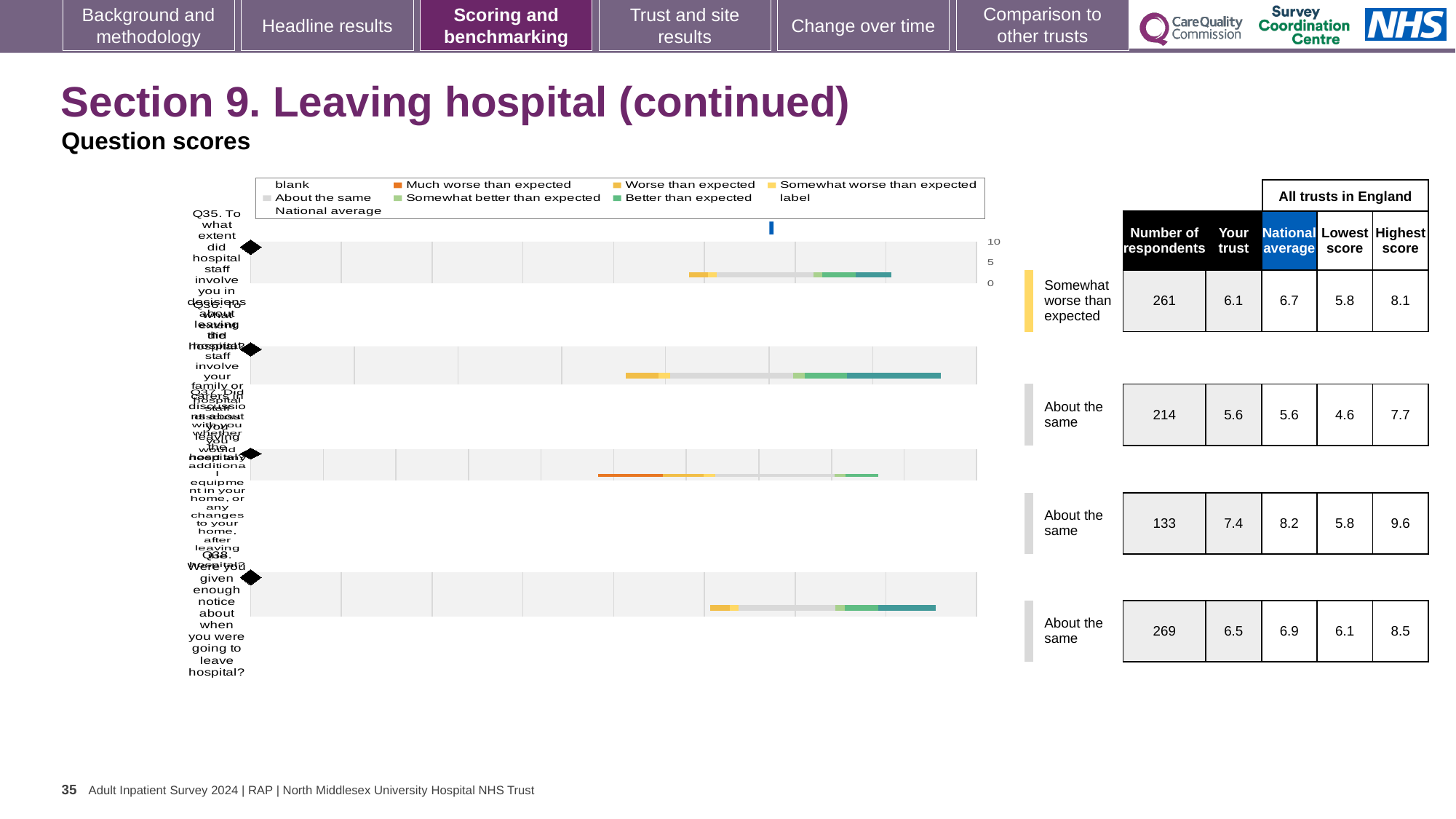
In the table beside the chart, what is the national average for the first row (Q35)? 6.7 In the table beside the chart, is the 'Your trust' score for the last row (Q38) larger or smaller than its national average? smaller Which legend entry is shown in dark orange? Much worse than expected In the table beside the chart, what is the 'Your trust' score for the first row (Q35)? 6.1 What kind of chart is used to show the question scores on this slide? bar chart In the table beside the chart, how many respondents are listed for the last row (Q38)? 269 How many question bars are plotted in the chart? 4 In the table beside the chart, which row has the highest 'Your trust' score? the third row (7.4) In the table beside the chart, what is the difference between the national average and the 'Your trust' score for the third row? 0.8 In the table beside the chart, what is the highest score for the third row? 9.6 What is the title of the slide containing the chart? Section 9. Leaving hospital (continued) In the table beside the chart, which row has the lowest number of respondents? the third row (133)